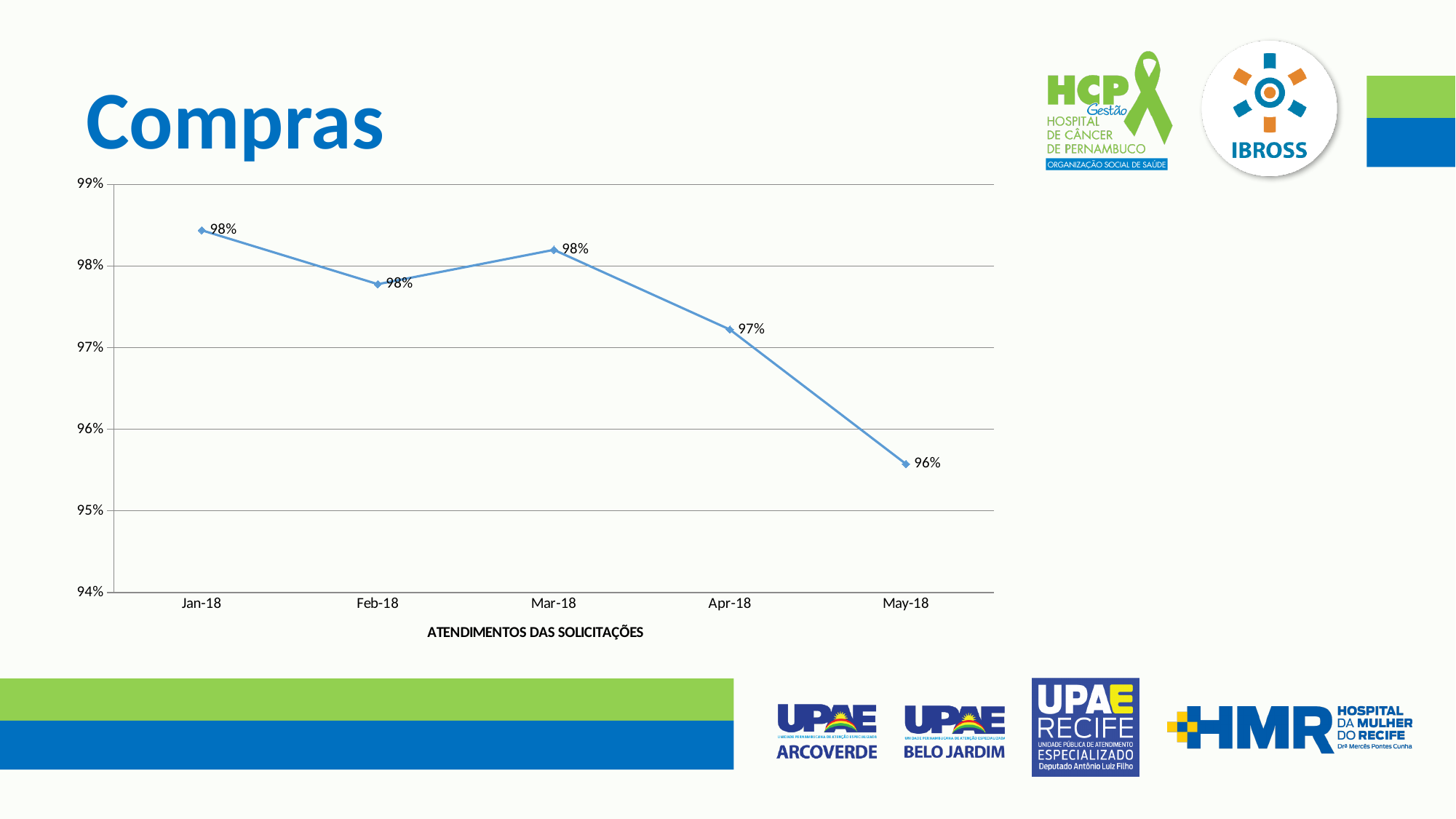
Which is larger, the value for Mar-18 or the value for Apr-18? Mar-18 Which month has the lowest value? May-18 What is the value for May-18? 96% What kind of chart is shown on the slide? line chart Do the values generally rise or fall from Jan-18 to May-18? fall What is the value for Jan-18? 98% How many months are plotted on the chart? 5 What is the value for Apr-18? 97% What is the difference between the labelled values for Jan-18 and May-18? 2%